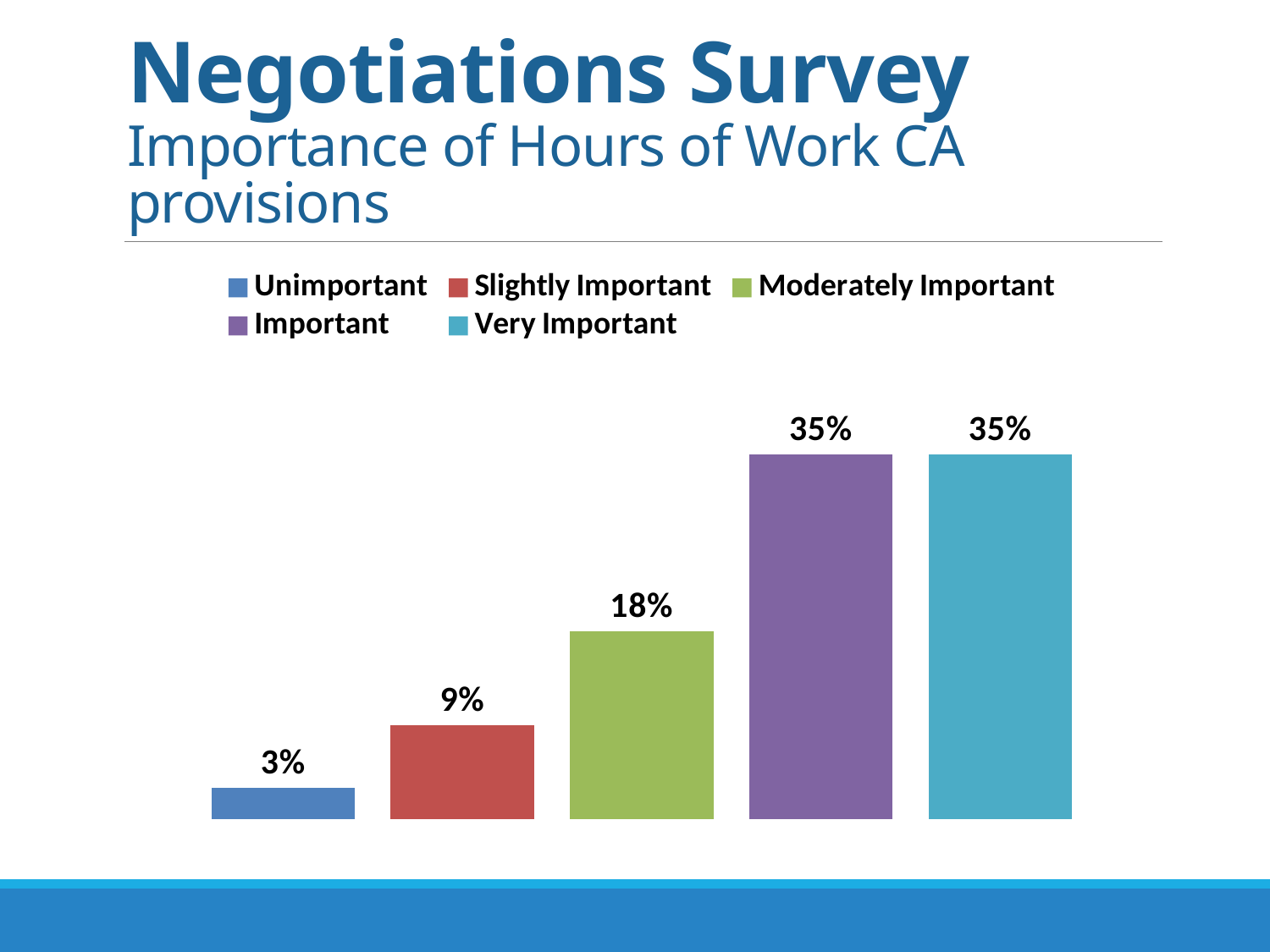
How many entries does the legend list? 5 What is the difference between the Important and Unimportant values? 32% Do the values rise or fall from left to right across the bars? Rise How many bars are shown in the chart? 5 What is the value for Very Important? 35% What percentage of respondents rated Hours of Work CA provisions as Unimportant? 3% What kind of chart is shown on the slide? Bar chart What is the value for Slightly Important? 9% Which category has the lowest value? Unimportant What is the value for Moderately Important? 18% Which is larger, the value for Moderately Important or the value for Slightly Important? Moderately Important What is the difference between the Moderately Important and Slightly Important values? 9%